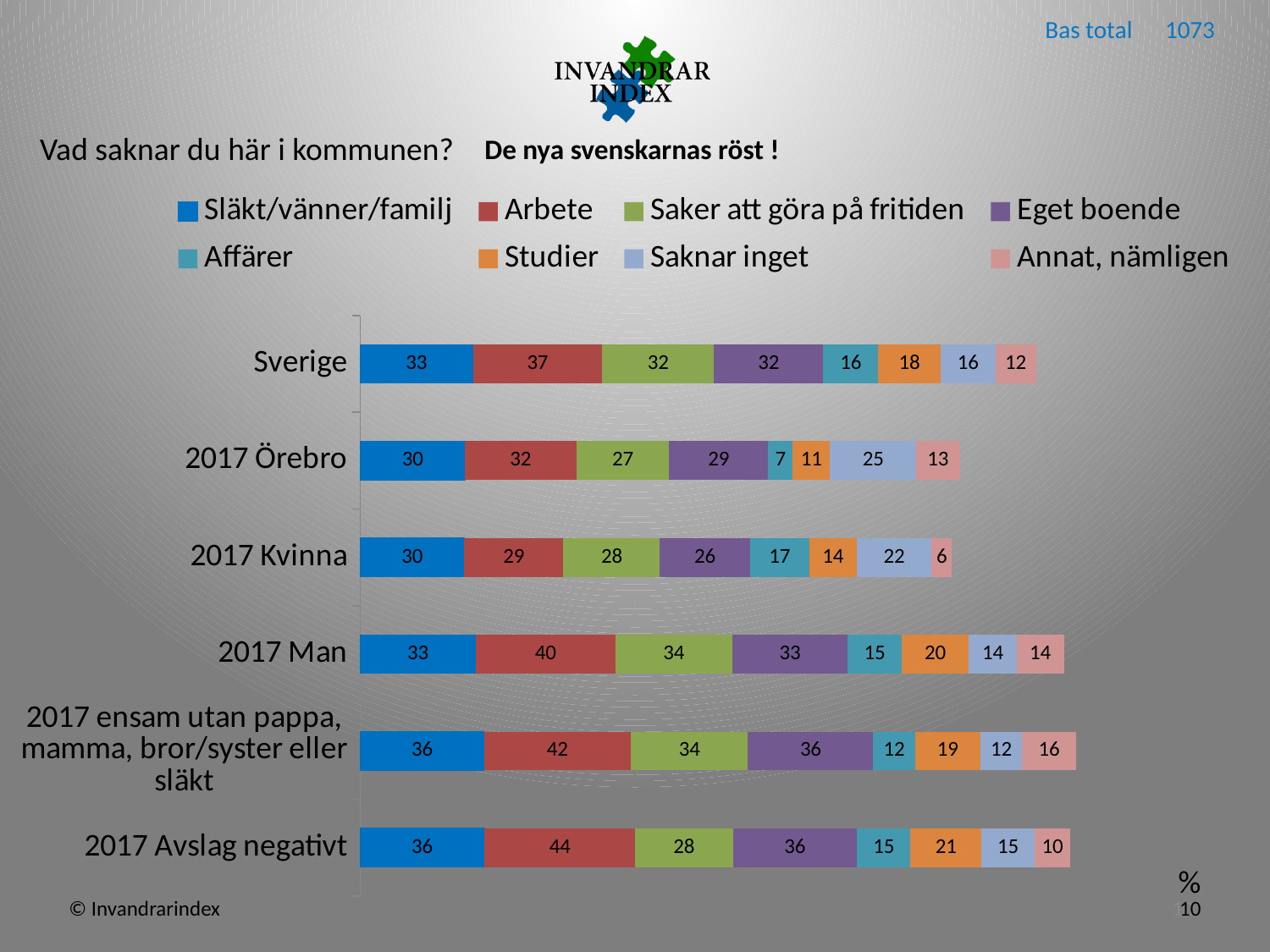
What is the difference between the Arbete values for 2017 Man and 2017 Kvinna? 11 What is the value for Saknar inget in the 2017 Örebro bar? 25 Which category has the highest value for Arbete? 2017 Avslag negativt How many series does the legend list? 8 How many categories are plotted on the chart? 6 What is the value for Arbete in the 2017 Avslag negativt bar? 44 Which category has the lowest value for Annat, nämligen? 2017 Kvinna What is the total of the stacked bar for 2017 Kvinna? 172 Which legend entry is shown in orange? Studier Which is larger: the Studier value for Sverige or for 2017 Örebro? Sverige What kind of chart is shown on the slide? Stacked bar chart What is the value for Affärer in the 2017 Kvinna bar? 17